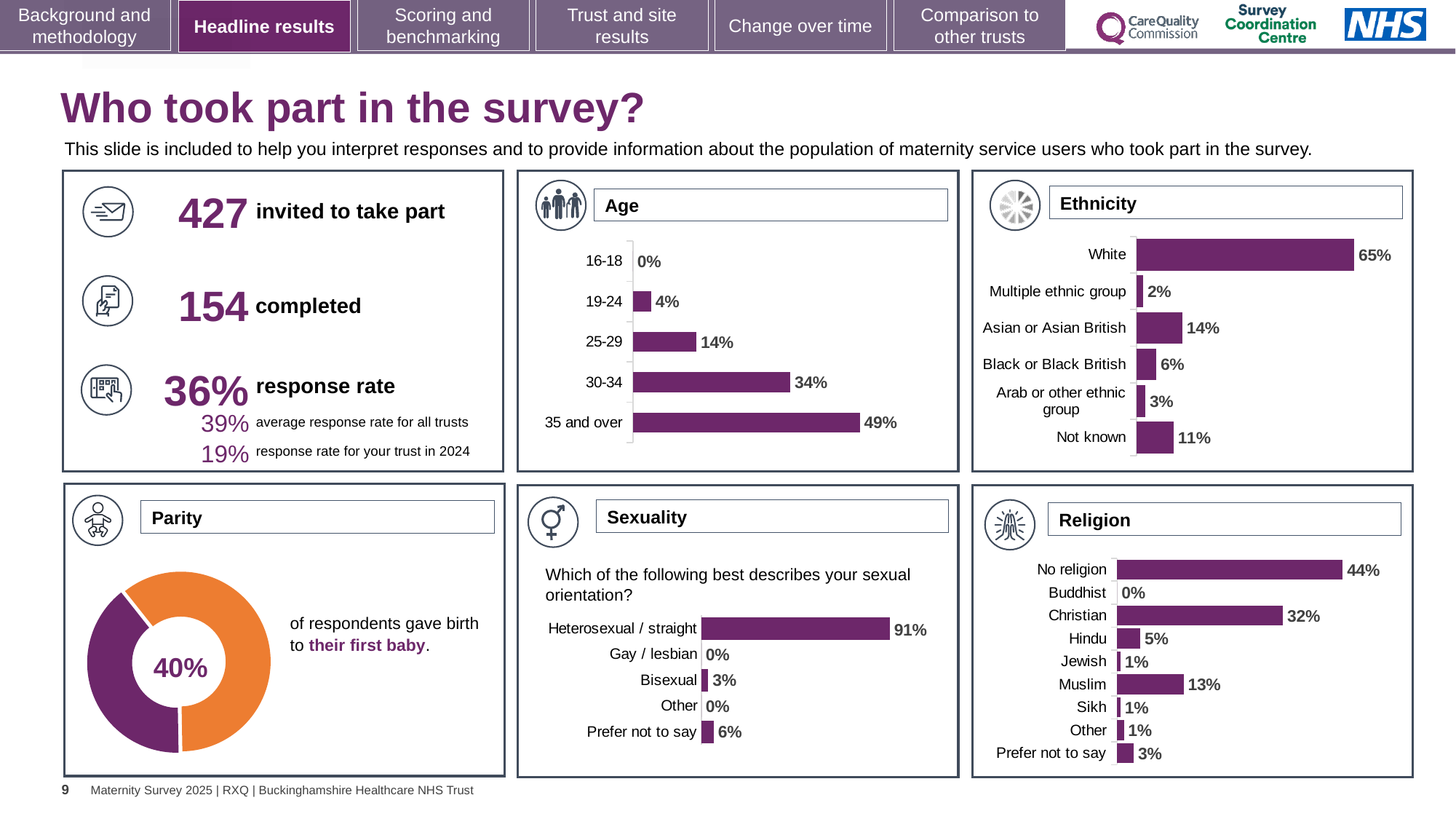
In the Age chart, which age group has the lowest value? 16-18 In the Ethnicity chart, which category has the highest value? White In the Religion chart, what is the value for Muslim? 13% In the Ethnicity chart, what is the value for Asian or Asian British? 14% In the Ethnicity chart, how many categories are shown? 6 In the Sexuality chart, what is the value for Prefer not to say? 6% In the Parity chart, what percentage of respondents gave birth to their first baby? 40% In the Age chart, what percentage of respondents were aged 35 and over? 49% What kind of chart is the Parity chart? Doughnut chart In the Age chart, what is the difference between the 30-34 and 25-29 values? 20% In the Religion chart, which is larger, Christian or No religion? No religion In the Religion chart, how many categories are shown? 9